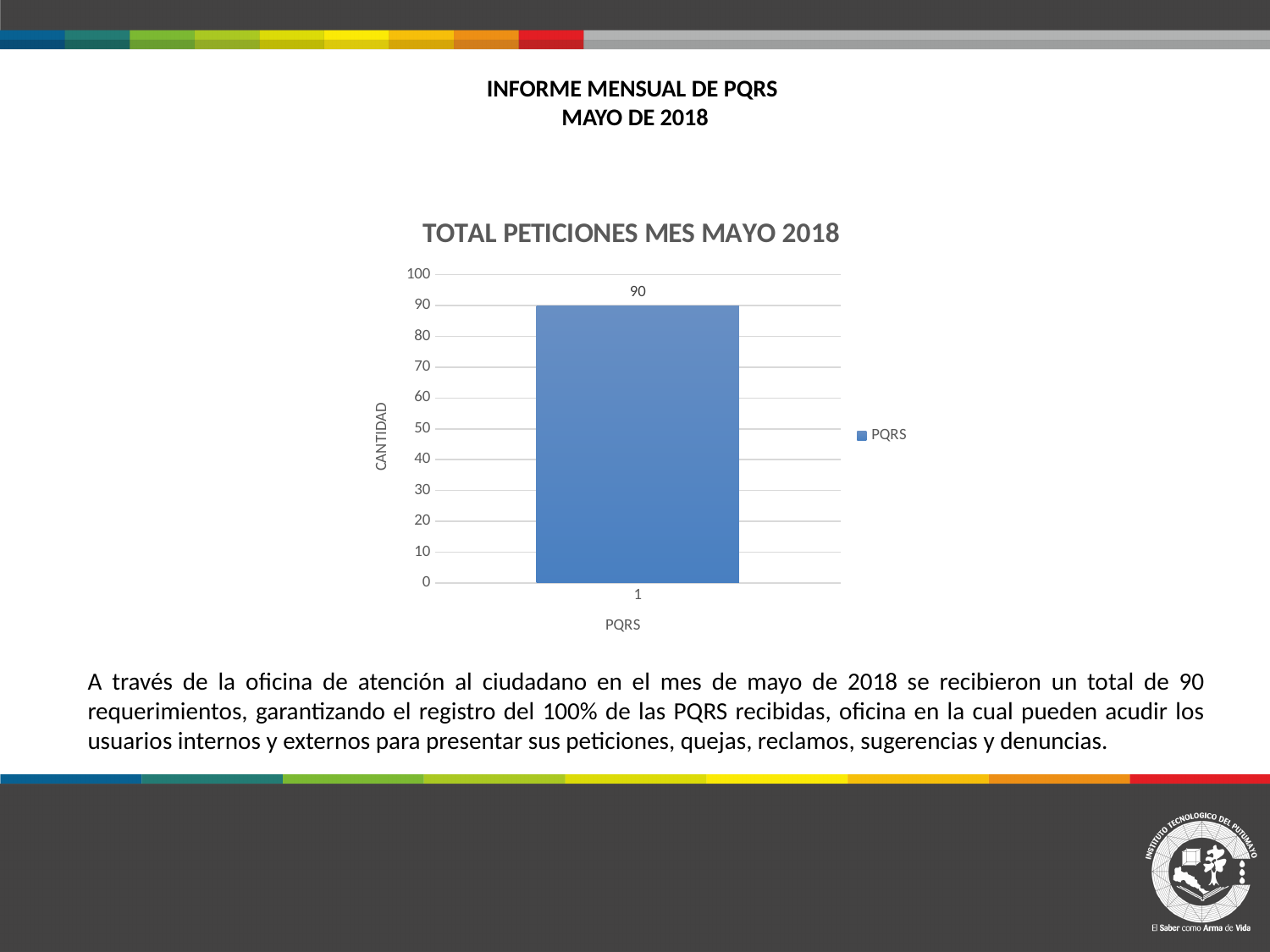
What is the label on the vertical axis of the chart? CANTIDAD Is the value of the PQRS bar greater or less than 50? greater What is the value of the PQRS bar in the chart? 90 What kind of chart is shown on the slide? bar chart How many series does the legend list? 1 What is the title of the chart? TOTAL PETICIONES MES MAYO 2018 What is the name of the series shown in the legend? PQRS How many bars does the chart have? 1 Is the value of the PQRS bar greater or less than 100? less What is the category label shown under the bar on the x axis? 1